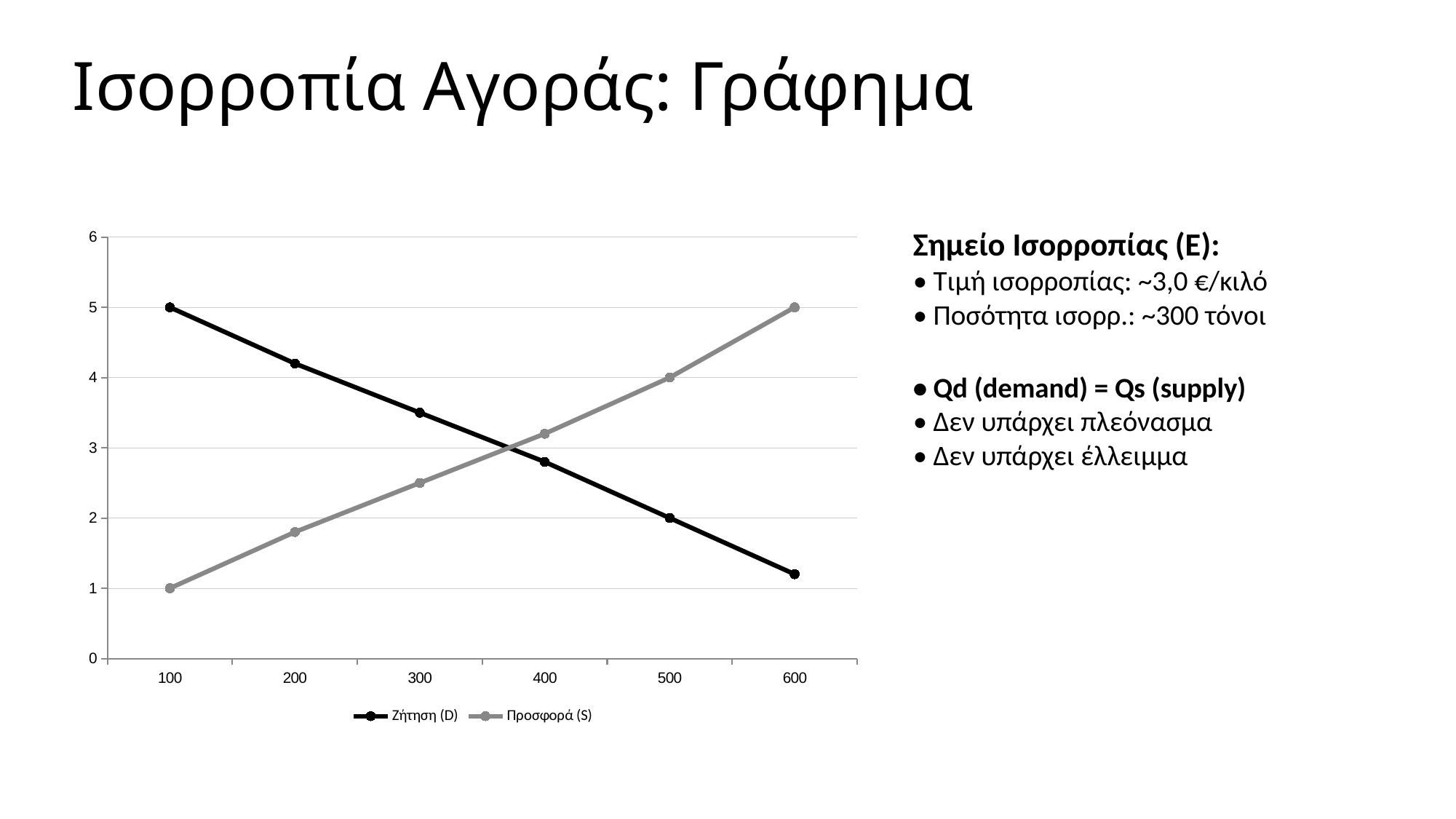
What is the value of Ζήτηση (D) at 500? 2 How many series does the legend list? 2 How many points are plotted along the x axis for each series? 6 What is the value of Προσφορά (S) at 600? 5 What kind of chart is shown on the slide? line chart At 200, which series has the larger value, Ζήτηση (D) or Προσφορά (S)? Ζήτηση (D) Does the Ζήτηση (D) line rise or fall as the x axis increases from 100 to 600? fall Does the Προσφορά (S) line rise or fall as the x axis increases from 100 to 600? rise Is the value for Ζήτηση (D) at 600 greater or less than 2? less What is the value of Προσφορά (S) at 100? 1 What is the value of Ζήτηση (D) at 100? 5 At which x value does Προσφορά (S) reach its highest value? 600